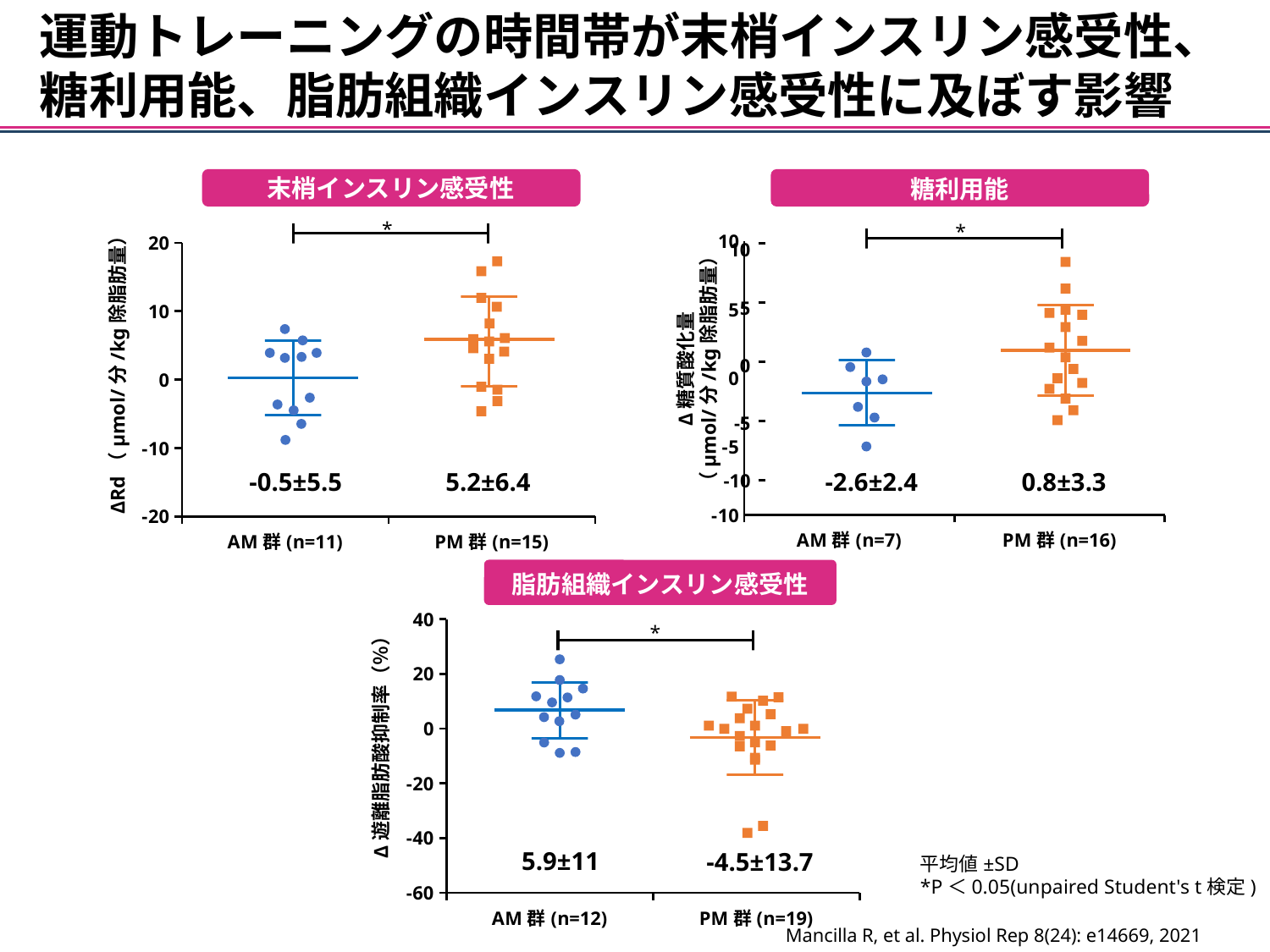
In the 脂肪組織インスリン感受性 chart, which group has the higher mean value, AM 群 or PM 群? AM 群 In the 末梢インスリン感受性 chart, what is the difference between the PM 群 mean (5.2) and the AM 群 mean (-0.5)? 5.7 In the 脂肪組織インスリン感受性 chart, what is the difference between the AM 群 mean (5.9) and the PM 群 mean (-4.5)? 10.4 In the 糖利用能 chart, which group has the higher mean value, AM 群 or PM 群? PM 群 What kind of chart is the 脂肪組織インスリン感受性 chart? Scatter (dot) plot In the 糖利用能 chart, what is the mean ± SD value shown for the AM 群? -2.6±2.4 How many groups are plotted on the x axis of the 糖利用能 chart? 2 In the 糖利用能 chart, what is the mean ± SD value shown for the PM 群? 0.8±3.3 In the 末梢インスリン感受性 chart, what is the mean ± SD value shown for the AM 群? -0.5±5.5 In the 脂肪組織インスリン感受性 chart, what is the mean ± SD value shown for the PM 群? -4.5±13.7 In the 末梢インスリン感受性 chart, what is the mean ± SD value shown for the PM 群? 5.2±6.4 In the 脂肪組織インスリン感受性 chart, what is the sample size (n) of the PM 群? 19